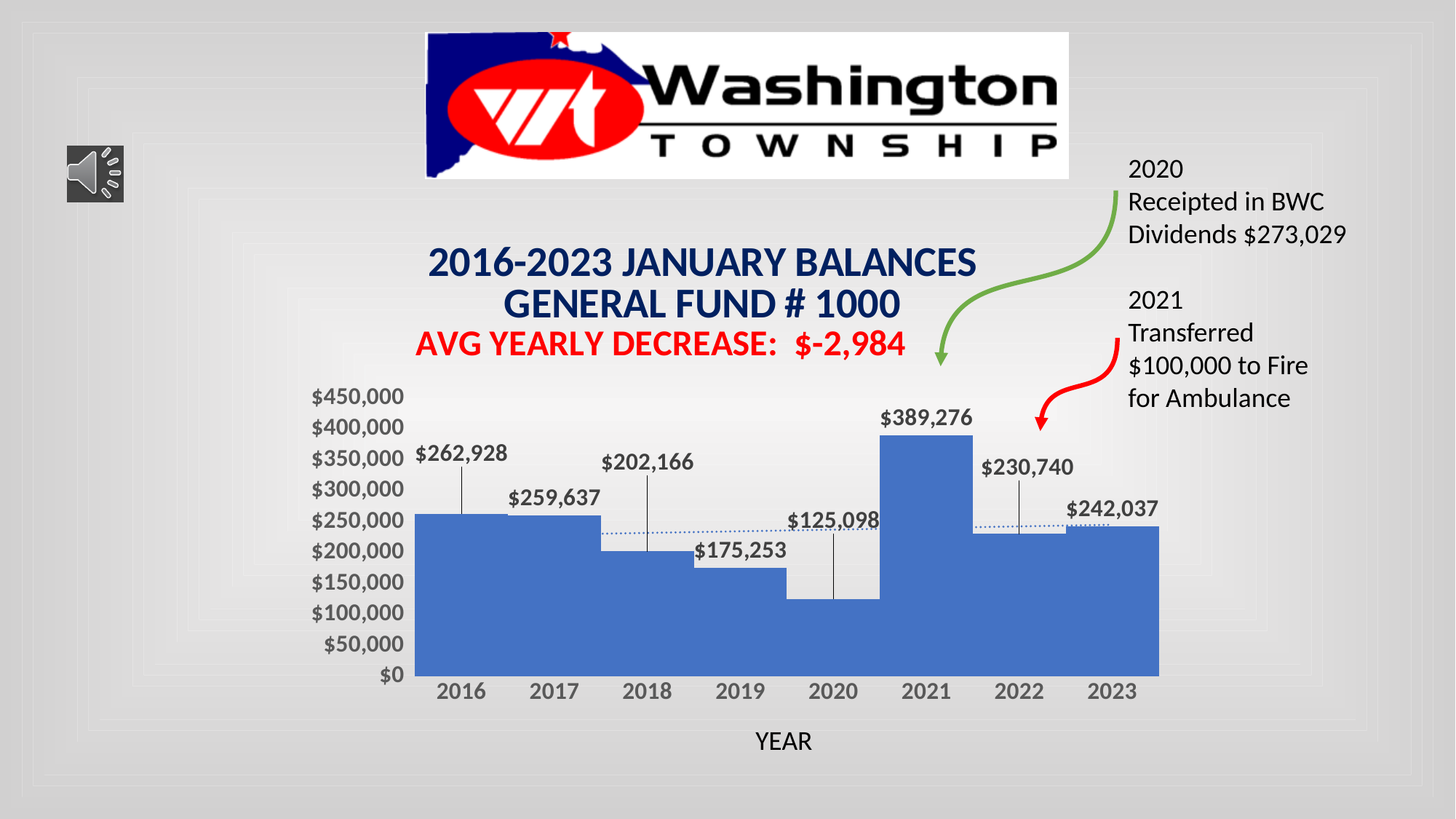
What is the January balance shown for 2018? $202,166 What is the difference between the 2021 and 2020 January balances? $264,178 Do the January balances rise or fall from 2016 to 2020? Fall What is the January balance shown for 2020? $125,098 What kind of chart is used to show the January balances? Bar chart Which year has the larger January balance, 2019 or 2022? 2022 Which year has the lowest January balance? 2020 What is the January balance shown for 2021? $389,276 How many years are plotted on the chart? 8 Which year has the highest January balance? 2021 Is the value for 2021 greater or less than $350,000? greater What is the difference between the 2023 and 2022 January balances? $11,297